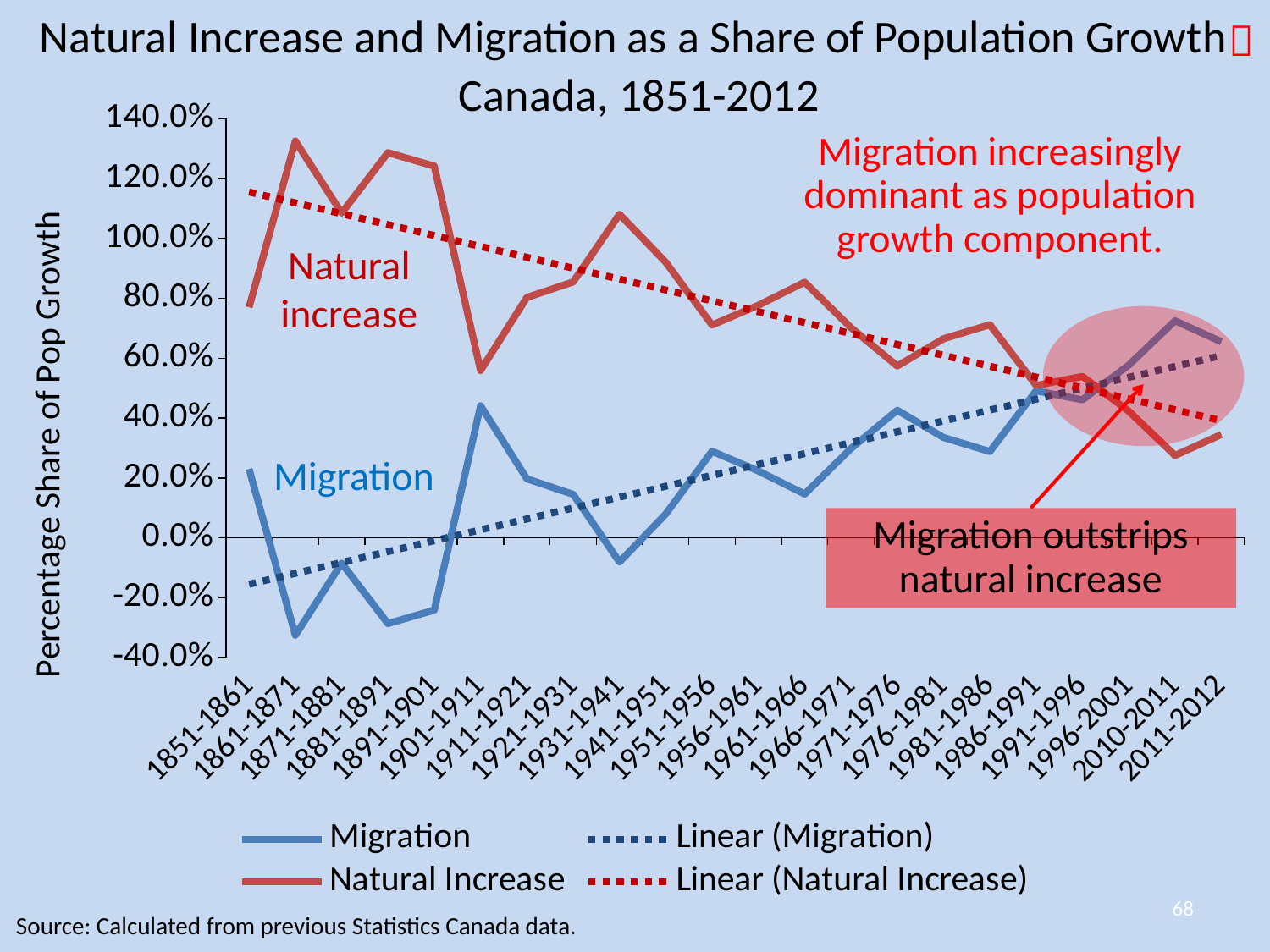
What is the label on the chart's vertical axis? Percentage Share of Pop Growth Does the Natural Increase series generally rise or fall across the periods shown? Fall In 2010-2011, which series has the larger value, Migration or Natural Increase? Migration Is the Natural Increase value for 2010-2011 greater or less than 40.0%? less Is the Migration value for 1861-1871 greater or less than -20.0%? less Does the Migration series generally rise or fall from 1851-1861 to 2011-2012? Rise Is the Natural Increase value for 1931-1941 greater or less than 100.0%? greater How many time periods are shown along the x axis of the chart? 22 What kind of chart is shown on the slide? Line chart How many entries does the chart's legend list? 4 In 1851-1861, which series has the larger value, Migration or Natural Increase? Natural Increase